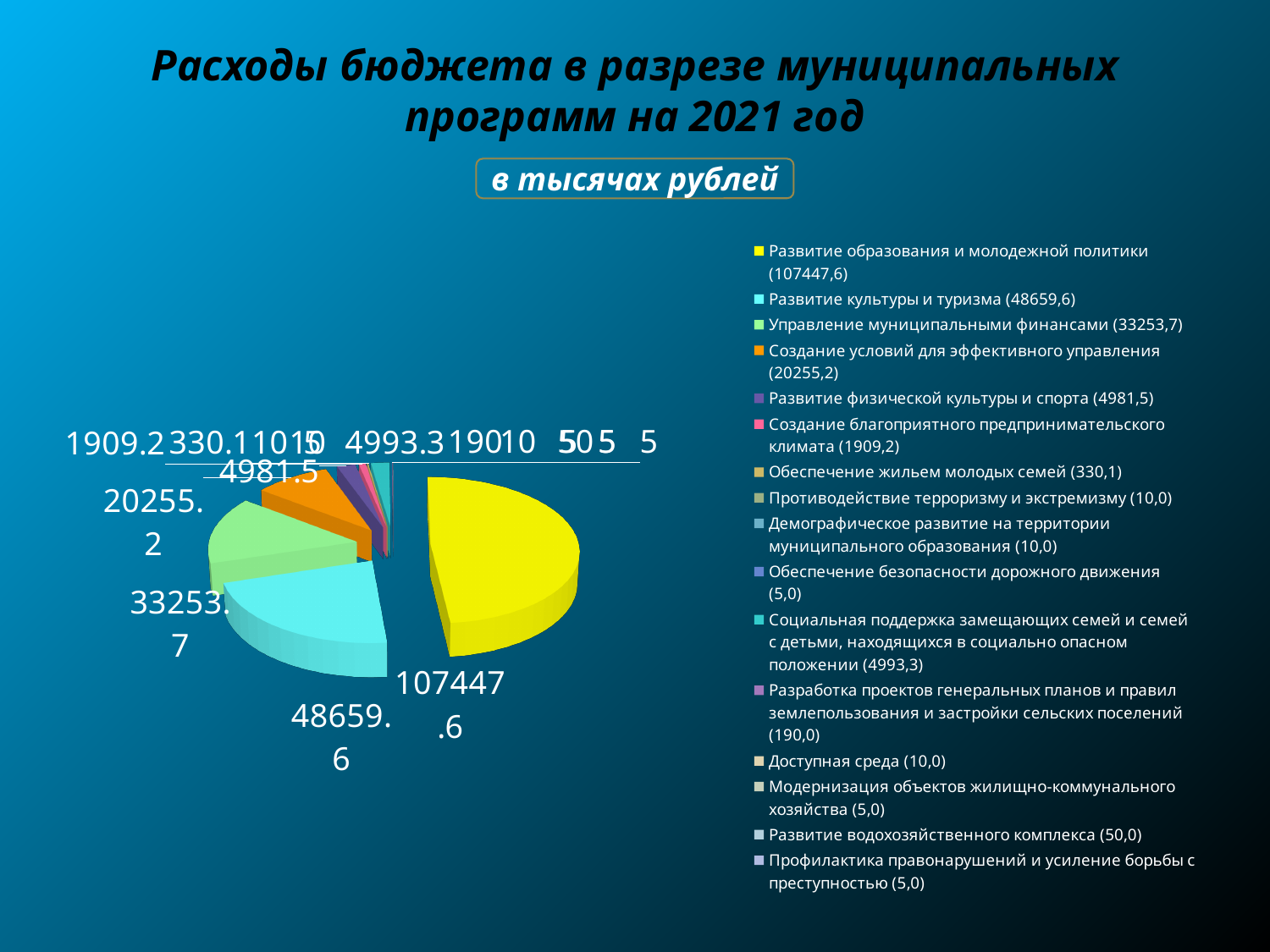
What is the value for Развитие культуры и туризма? 48659.6 In what units are the values on the chart expressed, according to the slide? в тысячах рублей Which category has the largest slice of the pie? Развитие образования и молодежной политики What is the difference between Управление муниципальными финансами and Создание условий для эффективного управления? 12998.5 What is the value for Создание условий для эффективного управления? 20255.2 What is the value for Развитие водохозяйственного комплекса? 50 What is the value for Развитие образования и молодежной политики? 107447.6 What is the value for Управление муниципальными финансами? 33253.7 What kind of chart is shown on the slide? pie chart What is the difference between Развитие образования и молодежной политики and Развитие культуры и туризма? 58788 How many categories does the legend list? 16 Which is larger: Развитие культуры и туризма or Управление муниципальными финансами? Развитие культуры и туризма